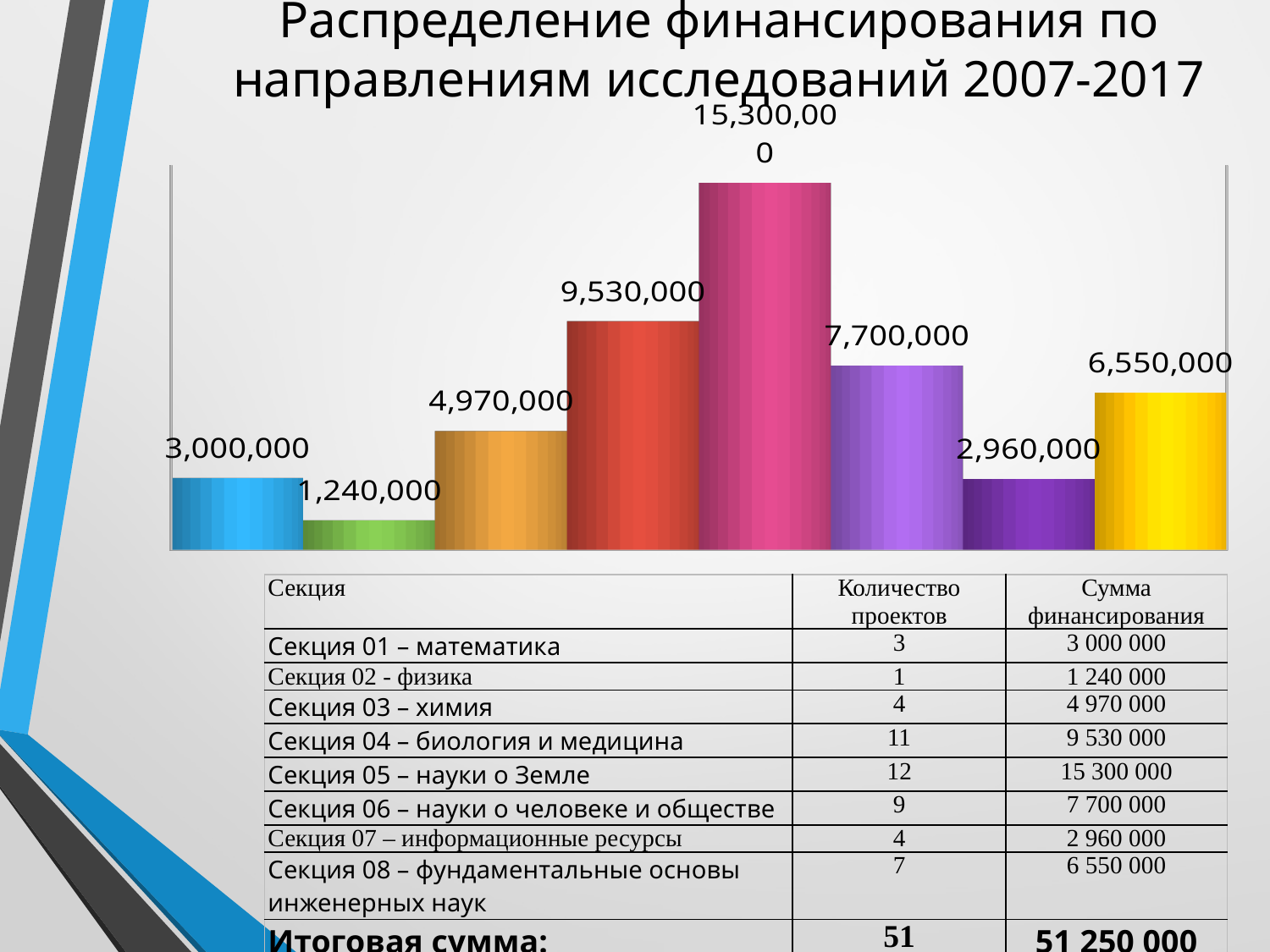
What is the title of the chart on the slide? Распределение финансирования по направлениям исследований 2007-2017 What is the value of the highest bar in the chart? 15,300,000 What kind of chart is shown on the slide? bar chart Which is larger: the first bar on the left or the last bar on the right? the last bar on the right (6,550,000) What value is labelled on the third bar from the left? 4,970,000 What is the total of all the bar values in the chart? 51,250,000 What is the value of the lowest bar in the chart? 1,240,000 What value is labelled on the sixth bar from the left (Секция 06 – науки о человеке и обществе)? 7,700,000 What is the difference between the highest bar and the first bar on the left? 12,300,000 What value is labelled on the last bar on the right? 6,550,000 How many bars does the chart contain? 8 What is the difference between the fourth bar (9,530,000) and the sixth bar (7,700,000)? 1,830,000